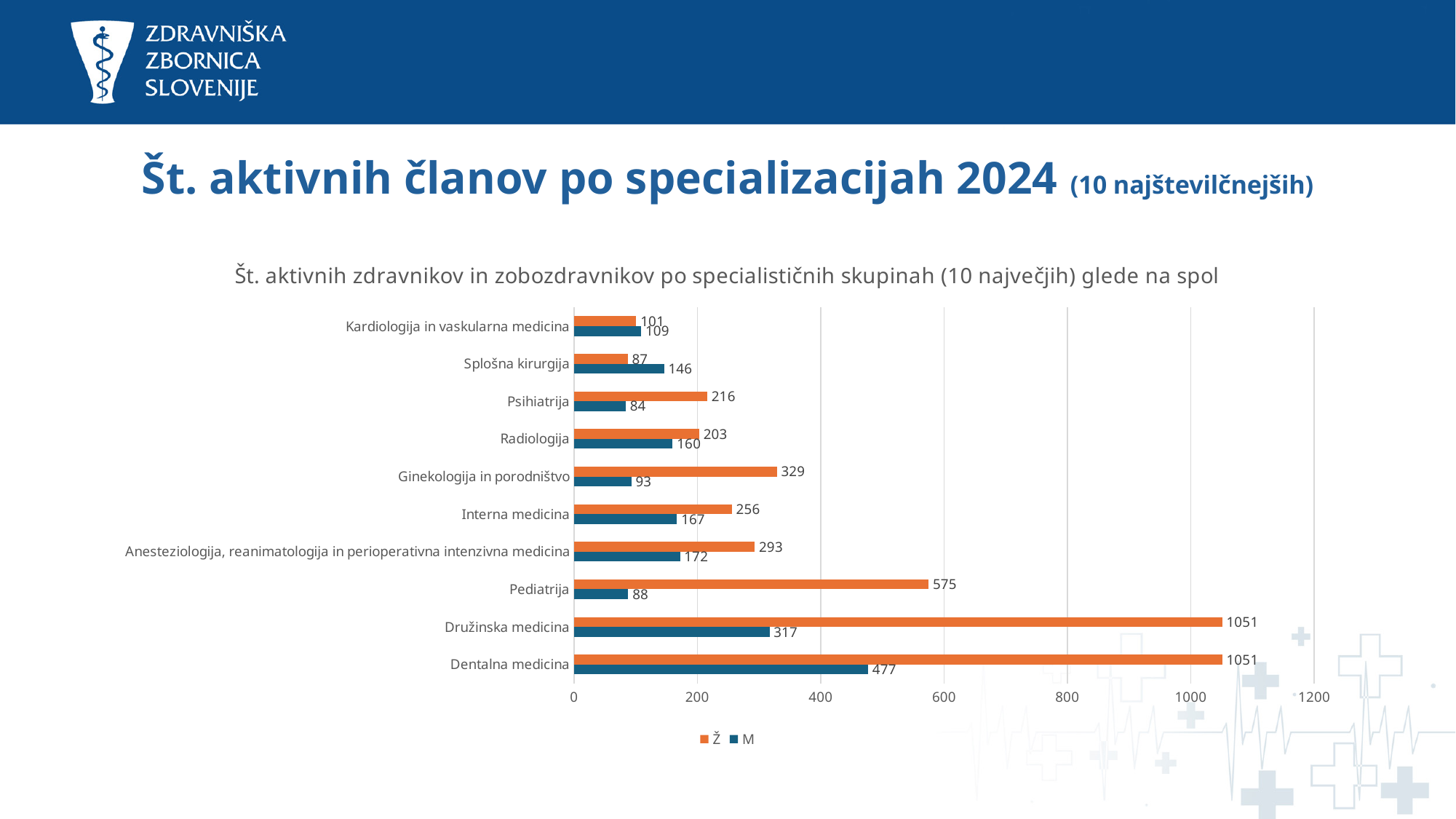
What kind of chart is shown on the slide? bar chart What is the value for Ž (women) in Pediatrija? 575 What is the value for M (men) in Dentalna medicina? 477 How many series does the legend list? 2 Is the value for Ž in Anesteziologija, reanimatologija in perioperativna intenzivna medicina greater or less than 200? greater Which category has the lowest value for Ž? Splošna kirurgija How many specialist groups are shown on the chart? 10 Which is larger in Splošna kirurgija, the Ž value or the M value? M What is the difference between the Ž and M values for Družinska medicina? 734 Which category has the highest value for M? Dentalna medicina Which colour represents the Ž series? orange What is the value for M in Ginekologija in porodništvo? 93